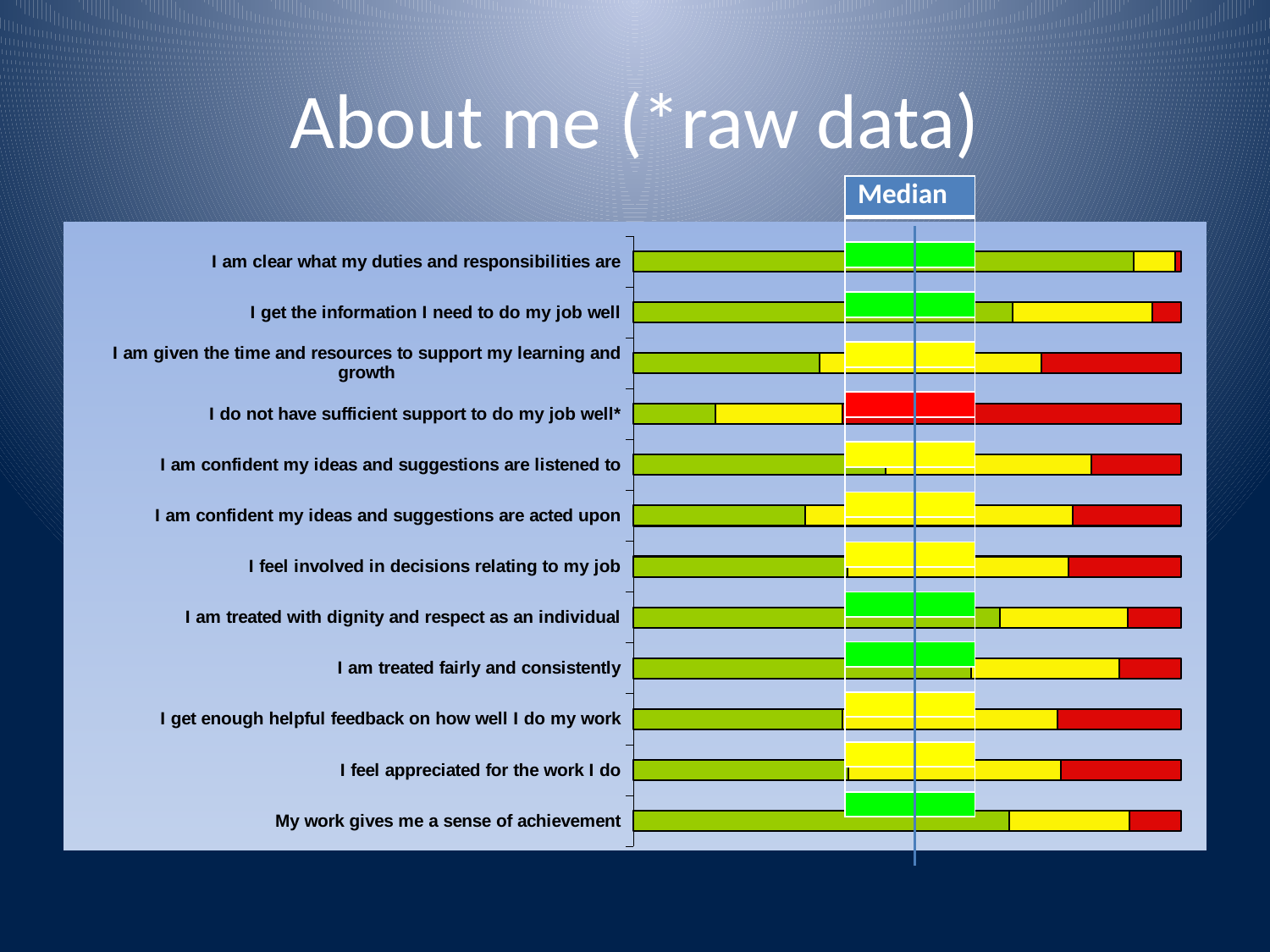
How many statements (categories) are plotted in the chart? 12 Which statement has the shortest green segment? I do not have sufficient support to do my job well* Which has the longer green segment: "I get the information I need to do my job well" or "I feel appreciated for the work I do"? I get the information I need to do my job well What is the title of the slide containing the chart? About me (*raw data) Which statement has the longest red segment? I do not have sufficient support to do my job well* Which statement has the smallest red segment? I am clear what my duties and responsibilities are Which statement has the longest green segment? I am clear what my duties and responsibilities are Which statement is marked with an asterisk in the chart? I do not have sufficient support to do my job well* Which has the longer red segment: "I am given the time and resources to support my learning and growth" or "My work gives me a sense of achievement"? I am given the time and resources to support my learning and growth Which has the longer yellow segment: "I do not have sufficient support to do my job well*" or "I am clear what my duties and responsibilities are"? I do not have sufficient support to do my job well* What kind of chart is shown on the slide? Stacked horizontal bar chart What label appears in the box above the highlighted column in the middle of the chart? Median